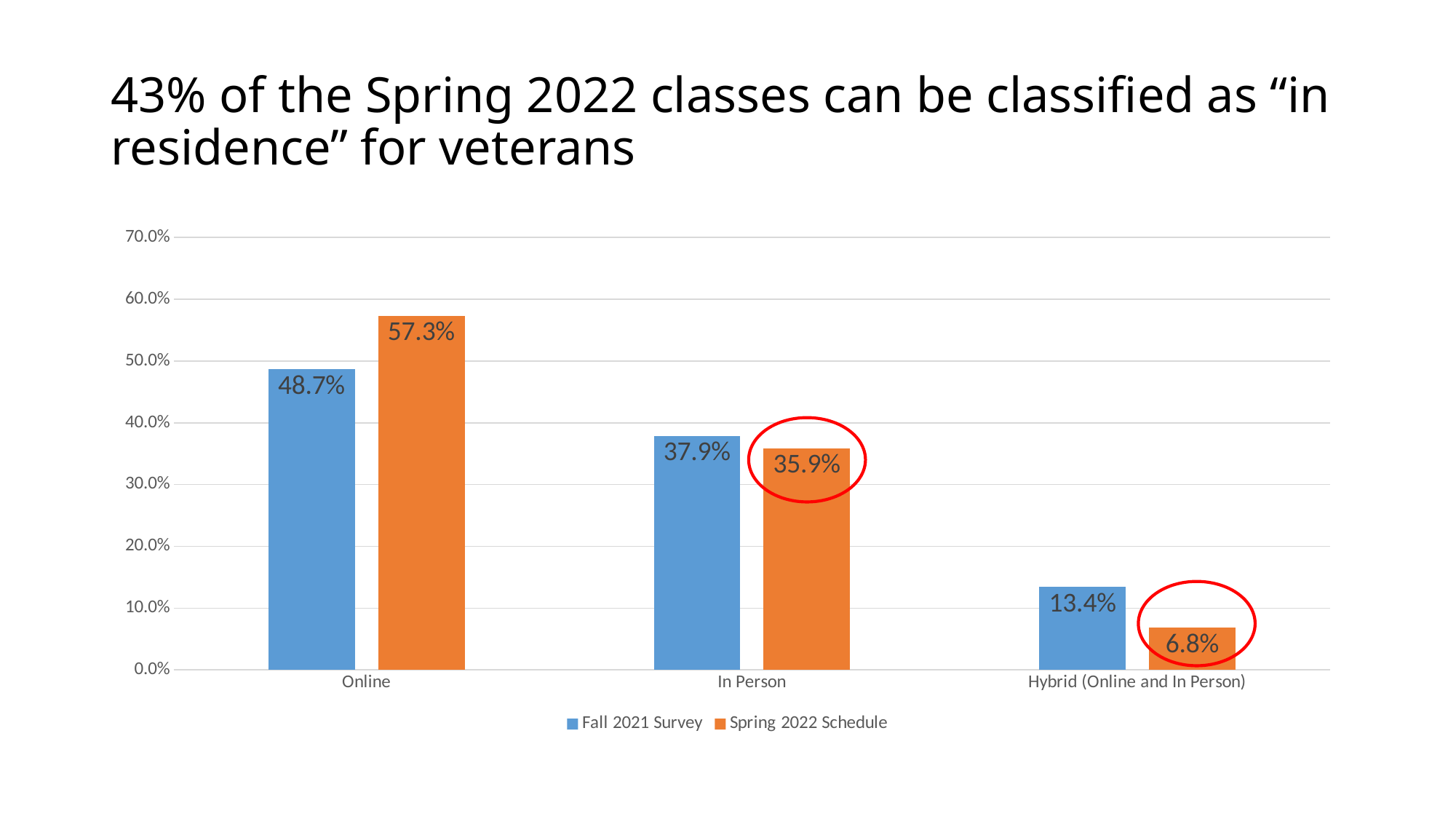
Which category has the highest Spring 2022 Schedule value? Online What is the Fall 2021 Survey value for Online? 48.7% What is the difference between the Spring 2022 Schedule and Fall 2021 Survey values for Online? 8.6% How many series does the legend list? 2 What kind of chart is shown on the slide? Bar chart What is the Spring 2022 Schedule value for Hybrid (Online and In Person)? 6.8% Which category has the lowest Fall 2021 Survey value? Hybrid (Online and In Person) For In Person, which series has the larger value, Fall 2021 Survey or Spring 2022 Schedule? Fall 2021 Survey How many categories are shown on the x axis? 3 What is the Fall 2021 Survey value for In Person? 37.9% What is the Spring 2022 Schedule value for Online? 57.3% Which colour represents the Spring 2022 Schedule series? Orange